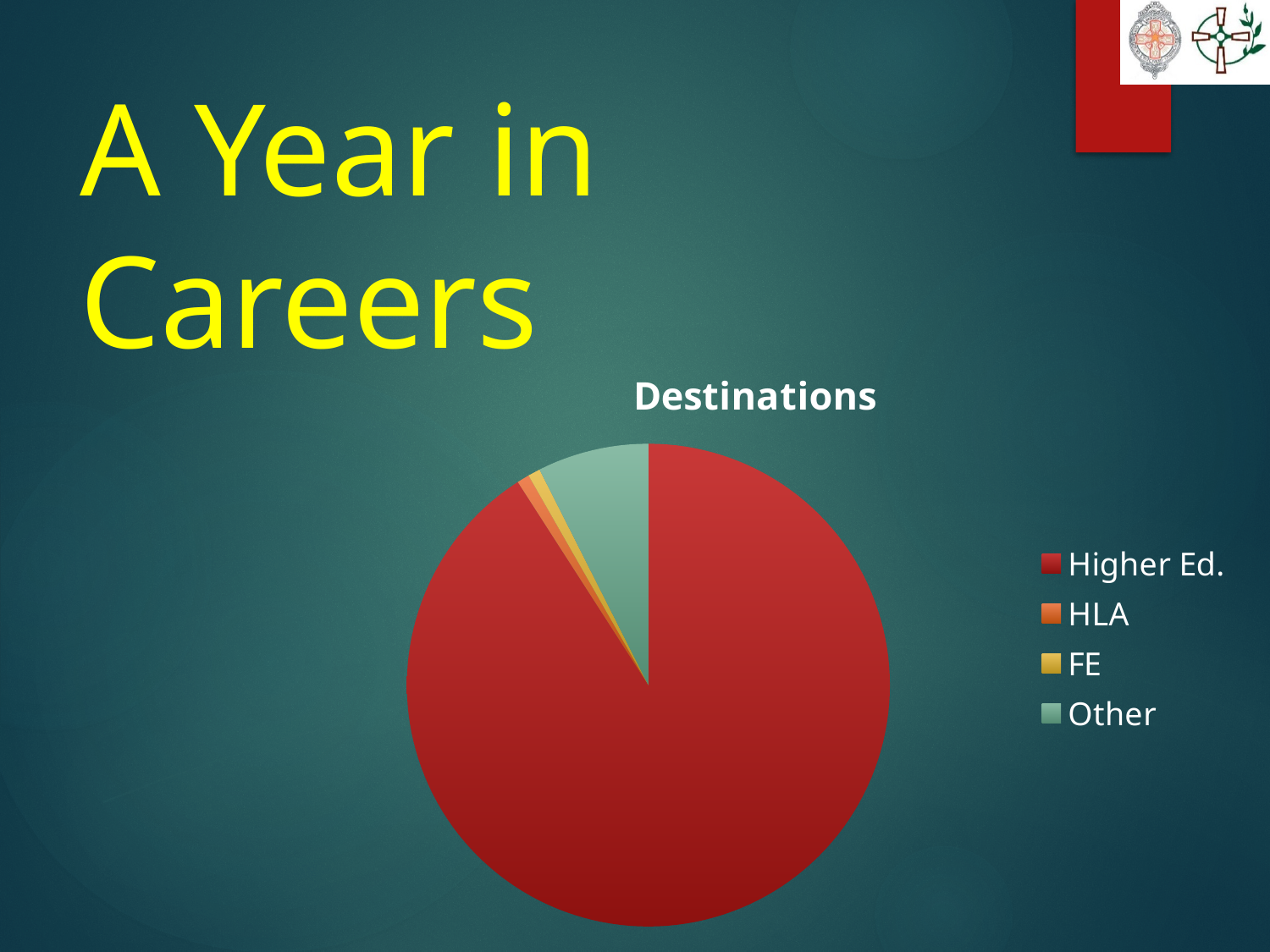
Which slice is larger in the Destinations chart, Other or HLA? Other Which slice is larger in the Destinations chart, Higher Ed. or Other? Higher Ed. Which slice is larger in the Destinations chart, Other or FE? Other How many slices does the Destinations pie chart have? 4 How many categories does the legend of the Destinations chart list? 4 What kind of chart is shown on the slide? pie chart What colour is the Higher Ed. slice in the Destinations chart? red Which category has the largest slice in the Destinations pie chart? Higher Ed. What is the title of the chart? Destinations